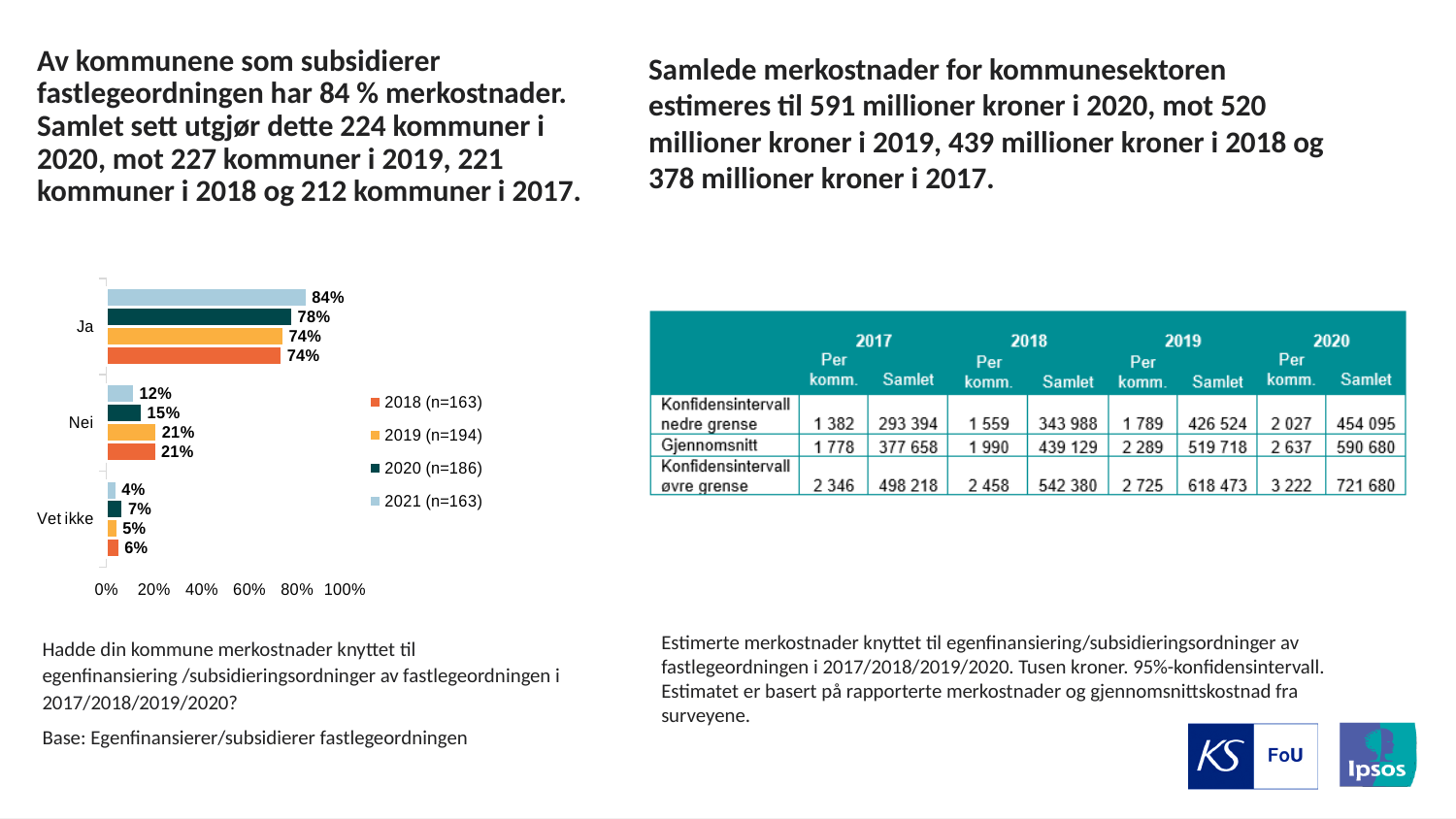
In the bar chart, what is the value for 'Ja' in the 2021 (n=163) series? 84% What kind of chart is shown on the left of the slide? bar chart How many categories are shown on the bar chart? 3 In the bar chart, what is the value for 'Nei' in the 2020 (n=186) series? 15% In the bar chart, which category has the lowest value in the 2020 (n=186) series? Vet ikke In the bar chart, what is the difference between the 'Ja' values for 2021 (n=163) and 2020 (n=186)? 6% In the bar chart, which series is shown in orange? 2018 (n=163) In the bar chart, what is the value for 'Ja' in the 2019 (n=194) series? 74% In the bar chart, what is the value for 'Vet ikke' in the 2018 (n=163) series? 6% In the bar chart, which category has the highest value in the 2021 (n=163) series? Ja In the bar chart, which is larger for 'Nei': the 2019 (n=194) value or the 2021 (n=163) value? 2019 (n=194) How many series does the legend of the bar chart list? 4